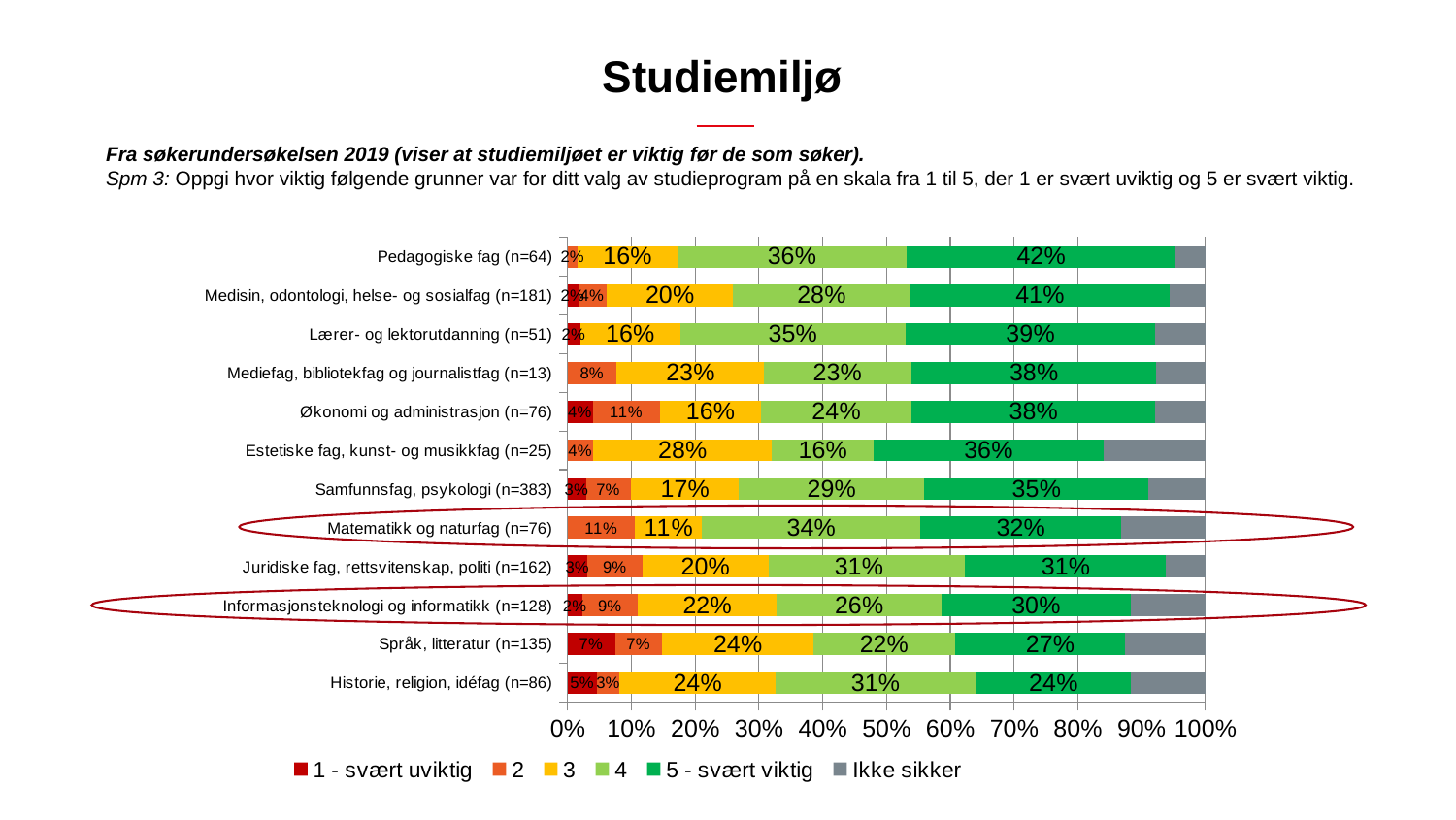
Which category has the lowest value for '5 - svært viktig'? Historie, religion, idéfag (n=86) What is the value of '5 - svært viktig' for Pedagogiske fag (n=64)? 42% How many series does the legend list? 6 What is the value of series '3' for Mediefag, bibliotekfag og journalistfag (n=13)? 23% Which category has the highest value for '5 - svært viktig'? Pedagogiske fag (n=64) What is the value of series '2' for Økonomi og administrasjon (n=76)? 11% What is the first entry in the chart legend? 1 - svært uviktig What is the difference between the '5 - svært viktig' values for Medisin, odontologi, helse- og sosialfag (n=181) and Informasjonsteknologi og informatikk (n=128)? 11 percentage points How many study-field categories are plotted in the chart? 12 What is the value of series '4' for Matematikk og naturfag (n=76)? 34% What kind of chart is shown on the slide? Stacked bar chart Which has the larger value for series '3': Estetiske fag, kunst- og musikkfag (n=25) or Språk, litteratur (n=135)? Estetiske fag, kunst- og musikkfag (n=25)